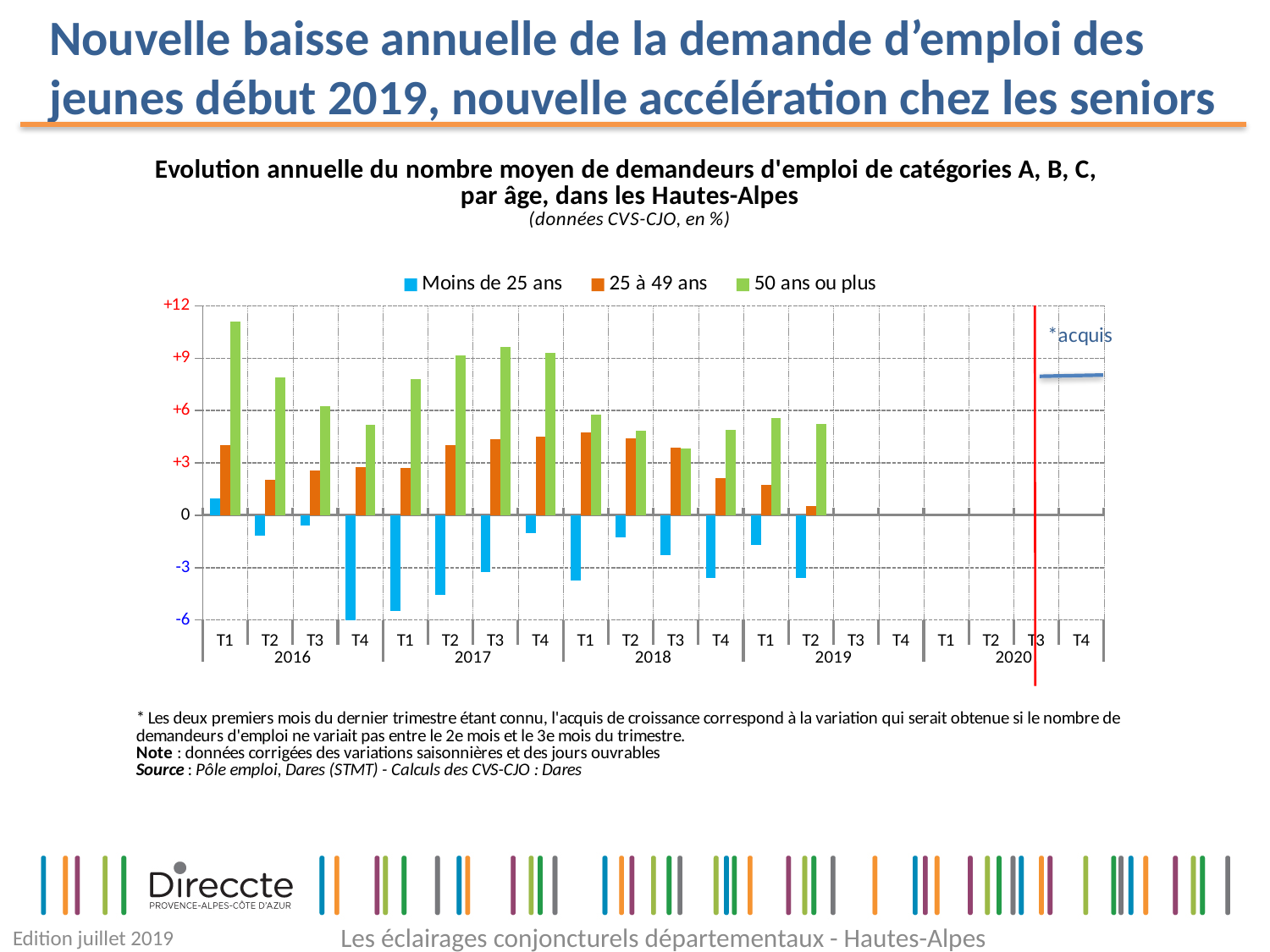
How many quarters have bars plotted on the chart? 14 In which quarter does the 'Moins de 25 ans' series reach its lowest value? T4 2016 What are the three series named in the legend? Moins de 25 ans, 25 à 49 ans, 50 ans ou plus Is the value for 'Moins de 25 ans' in T4 2016 greater or less than -3? less How many series does the legend list? 3 Is the value for '25 à 49 ans' in T1 2018 greater or less than +3? greater Is the value for '25 à 49 ans' in T2 2019 greater or less than +3? less Which is larger for '25 à 49 ans': the value in T1 2016 or the value in T2 2016? T1 2016 Which series is shown in green? 50 ans ou plus In which quarter does the '50 ans ou plus' series reach its highest value? T1 2016 What kind of chart is shown on the slide? bar chart